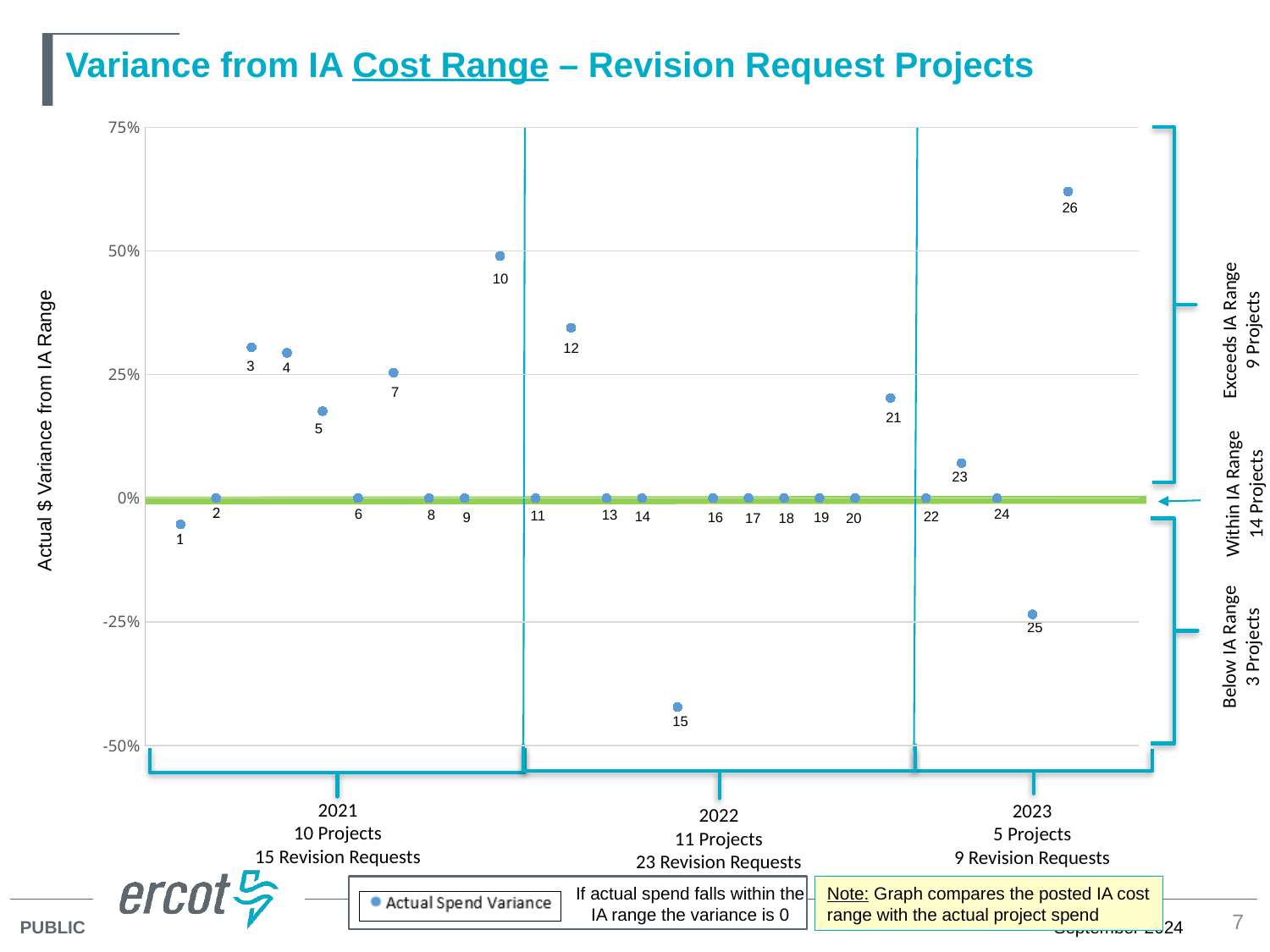
Is the value for project 26 greater or less than 50%? greater Which has the larger variance, project 3 or project 5? Project 3 What is the variance value plotted for project 13? 0% Is the value for project 15 greater or less than -25%? less Which project number has the highest variance from IA range? 26 Which project number has the lowest variance from IA range? 15 Is the value for project 12 greater or less than 25%? greater How many series does the legend list? 1 What is the name of the series shown in the legend? Actual Spend Variance What kind of chart is shown on the slide? Scatter chart How many data points are plotted on the chart? 26 What is the title of the vertical axis? Actual $ Variance from IA Range